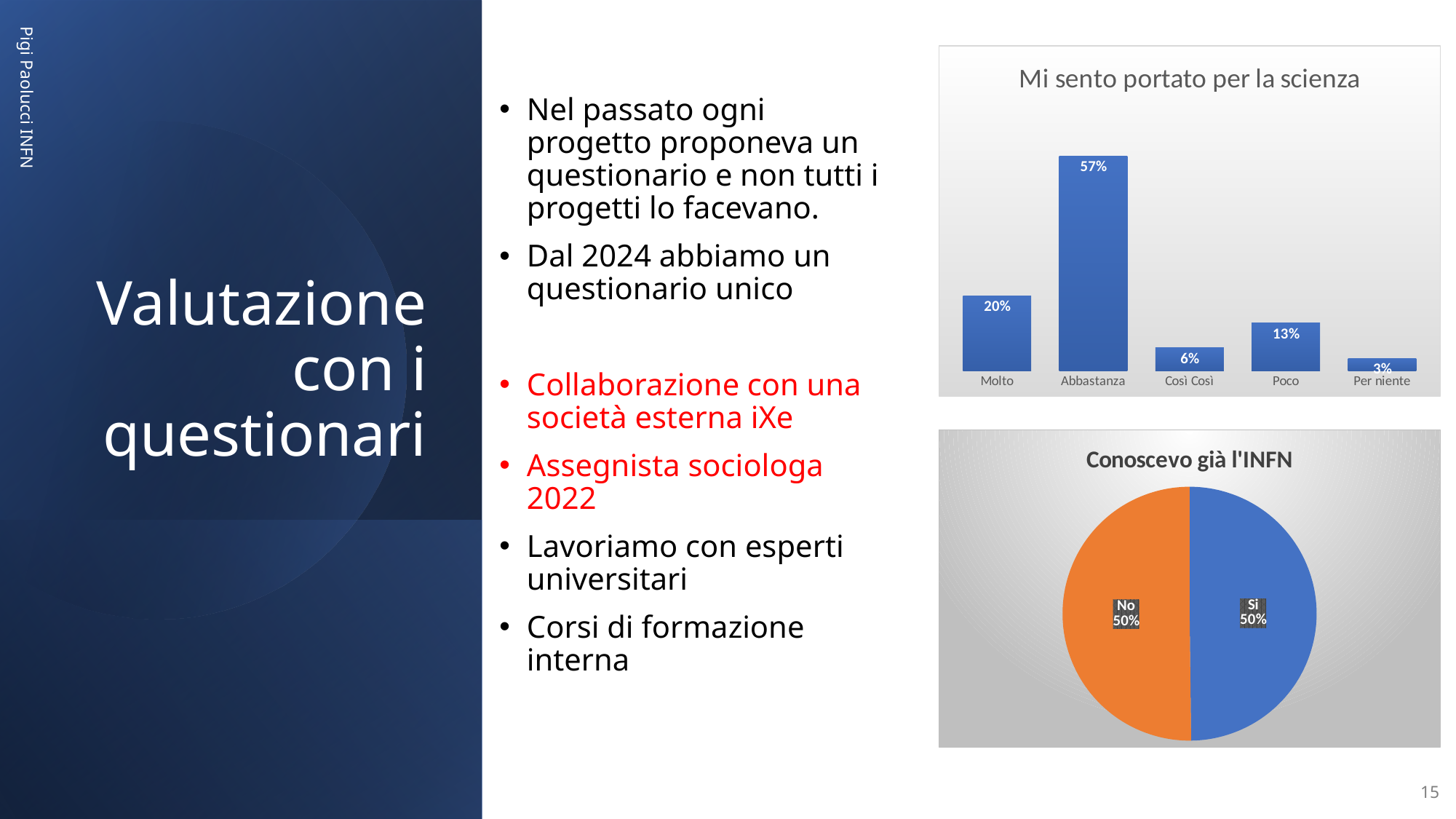
In the chart titled "Mi sento portato per la scienza", which category has the highest value? Abbastanza What kind of chart is "Conoscevo già l'INFN"? Pie chart In the chart titled "Mi sento portato per la scienza", what is the value for Abbastanza? 57% In the chart titled "Mi sento portato per la scienza", which is larger: Poco or Così Così? Poco In the chart titled "Conoscevo già l'INFN", what share of the pie is Si? 50% In the chart titled "Conoscevo già l'INFN", what colour is the No slice? Orange In the chart titled "Mi sento portato per la scienza", which category has the lowest value? Per niente What kind of chart is "Mi sento portato per la scienza"? Bar chart How many categories are shown in the chart titled "Mi sento portato per la scienza"? 5 In the chart titled "Mi sento portato per la scienza", what is the value for Molto? 20% In the chart titled "Mi sento portato per la scienza", what is the value for Poco? 13% In the chart titled "Mi sento portato per la scienza", what is the difference between Abbastanza and Molto? 37%